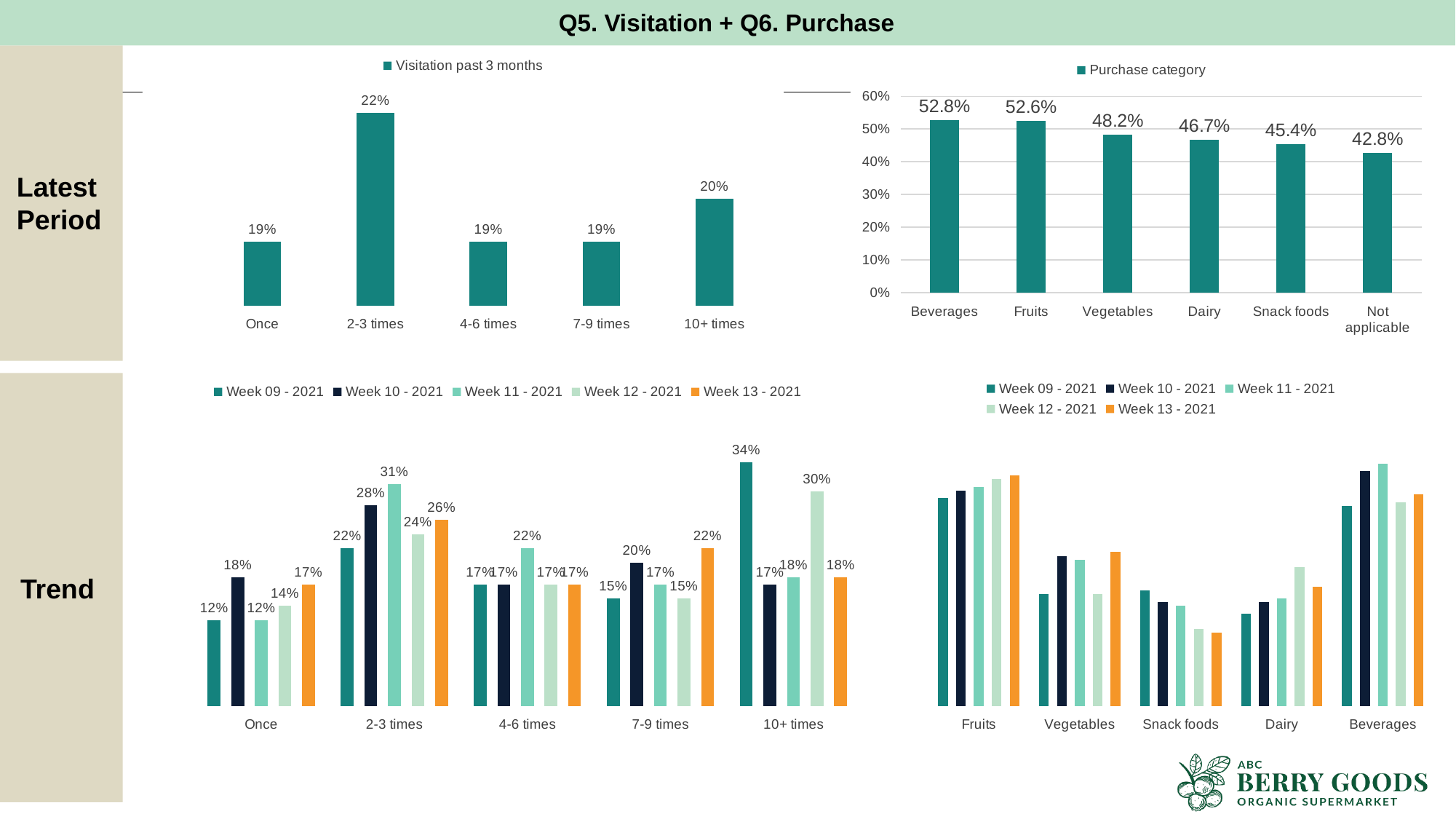
In the 'Purchase category' chart, what is the value for Dairy? 46.7% In the bottom-left trend chart of visitation, what is the value for 2-3 times in Week 11 - 2021? 31% In the 'Purchase category' chart, what is the difference between Beverages and Snack foods? 7.4% In the bottom-right trend chart of purchase categories, which is larger for Snack foods: Week 09 - 2021 or Week 13 - 2021? Week 09 - 2021 In the 'Purchase category' chart, which category has the lowest value? Not applicable How many categories are shown in the 'Visitation past 3 months' chart? 5 In the 'Visitation past 3 months' chart, which category has the highest value? 2-3 times How many series does the legend list in the bottom-left trend chart of visitation? 5 In the 'Visitation past 3 months' chart, what is the value for 10+ times? 20% In the bottom-left trend chart of visitation, what is the value for 10+ times in Week 09 - 2021? 34% In the 'Purchase category' chart, is the value for Vegetables greater or less than 40%? greater What kind of chart is the 'Purchase category' chart? Bar chart